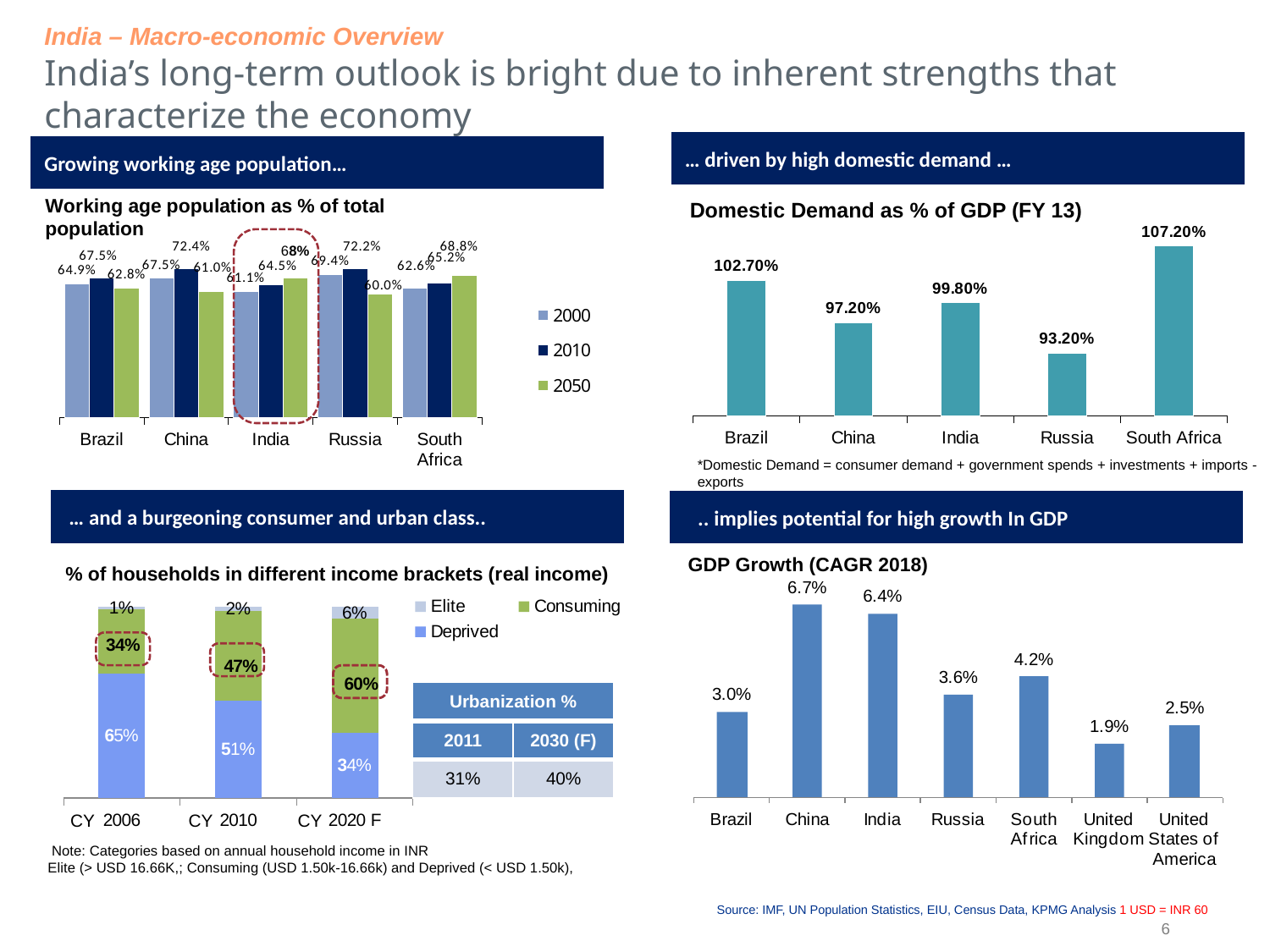
In the Working age population as % of total population chart, how many series does the legend list? 3 In the GDP Growth (CAGR 2018) chart, what is the value for India? 6.4% In the Domestic Demand as % of GDP (FY 13) chart, how many countries are shown? 5 In the GDP Growth (CAGR 2018) chart, which country has the highest value? China In the % of households in different income brackets chart, what is the total of the stacked bar for CY 2020 F? 100% In the GDP Growth (CAGR 2018) chart, which is larger, the value for Russia or the value for United States of America? Russia In the Working age population as % of total population chart, what is the 2050 value for India? 68% In the Domestic Demand as % of GDP (FY 13) chart, what is the value for South Africa? 107.20% In the Domestic Demand as % of GDP (FY 13) chart, which country has the lowest value? Russia In the % of households in different income brackets chart, what is the Consuming share for CY 2010? 47% In the GDP Growth (CAGR 2018) chart, what is the difference between South Africa and United Kingdom? 2.3% In the Domestic Demand as % of GDP (FY 13) chart, what is the difference between Brazil and India? 2.90%